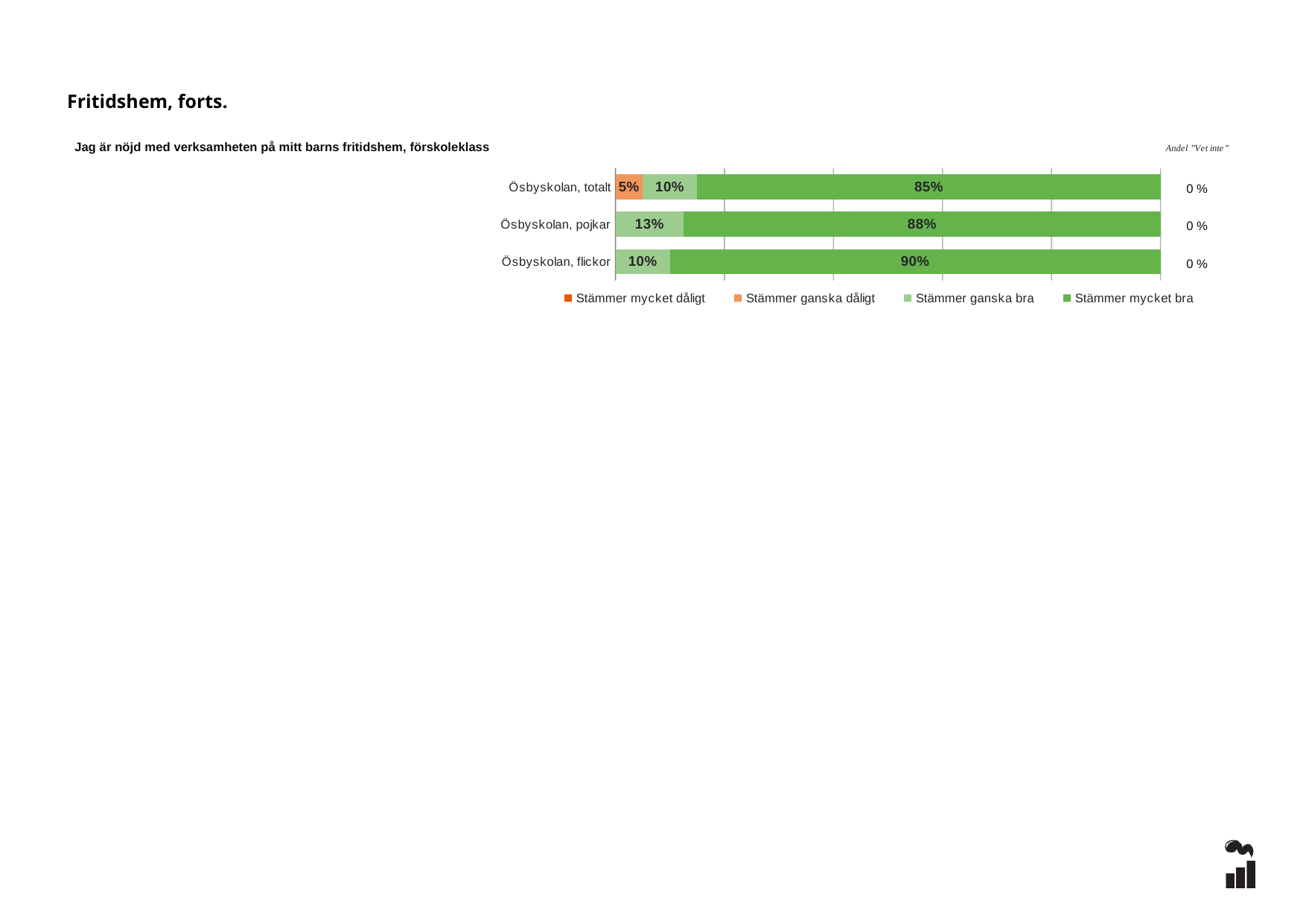
How many series does the legend list? 4 Which category has the lowest value for "Stämmer mycket bra"? Ösbyskolan, totalt What is the value for "Stämmer mycket bra" for Ösbyskolan, totalt? 85% Which category has the highest value for "Stämmer mycket bra"? Ösbyskolan, flickor What is the value for "Stämmer ganska bra" for Ösbyskolan, pojkar? 13% How many categories are shown on the chart? 3 What is the "Andel Vet inte" value shown for Ösbyskolan, pojkar? 0 % What kind of chart is shown on the slide? Stacked bar chart What is the value for "Stämmer ganska dåligt" for Ösbyskolan, totalt? 5% Which is larger: the "Stämmer ganska bra" value for Ösbyskolan, pojkar or for Ösbyskolan, flickor? Ösbyskolan, pojkar What is the value for "Stämmer mycket bra" for Ösbyskolan, flickor? 90% What is the difference between the "Stämmer mycket bra" values for Ösbyskolan, flickor and Ösbyskolan, totalt? 5%